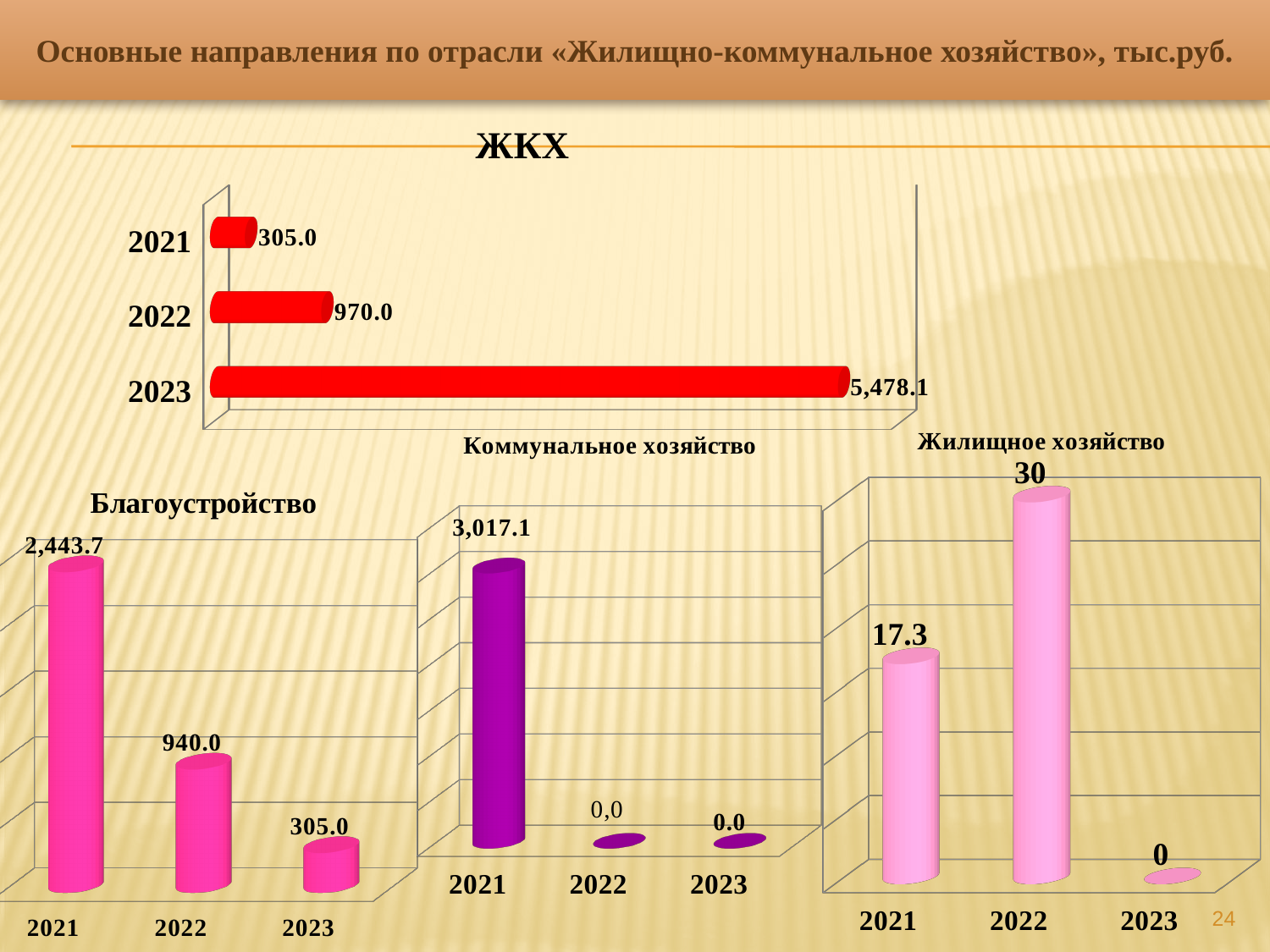
In the Коммунальное хозяйство chart, which year has the highest value? 2021 In the ЖКХ chart, what is the difference between the 2023 and 2022 values? 4,508.1 In the ЖКХ chart, which year has the lowest value? 2021 In the Благоустройство chart, do the values rise or fall from 2021 to 2023? fall In the Благоустройство chart, what is the value for 2021? 2,443.7 In the Коммунальное хозяйство chart, what is the value for 2021? 3,017.1 In the Жилищное хозяйство chart, which is larger, the value for 2021 or 2022? 2022 In the Благоустройство chart, what is the difference between the 2022 and 2023 values? 635.0 In the Жилищное хозяйство chart, what is the value for 2022? 30 How many charts are shown on the slide? 4 In the ЖКХ chart, what is the value for 2023? 5,478.1 In the ЖКХ chart, what is the value for 2022? 970.0